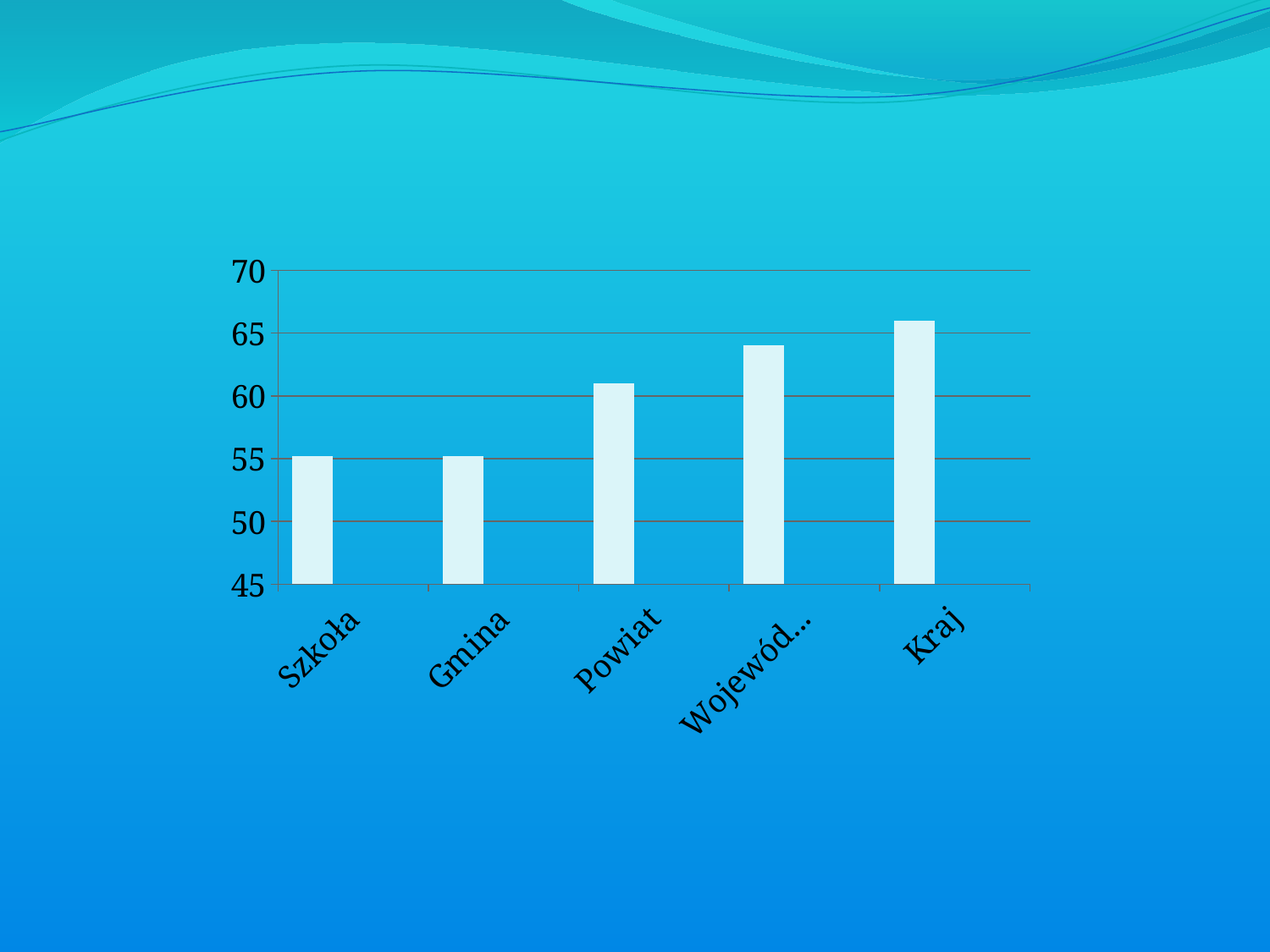
Which is larger, the value for Kraj or the value for Powiat? Kraj Do the bar values generally rise or fall from Szkoła on the left to Kraj on the right? rise Is the value for Powiat greater or less than 60? greater What is the lowest value shown on the vertical axis of the chart? 45 Which is larger, the value for Powiat or the value for Gmina? Powiat What is the highest value shown on the vertical axis of the chart? 70 Which category has the highest bar in the chart? Kraj What kind of chart is shown on the slide? bar chart Is the value for Szkoła greater or less than 60? less Is the value for Kraj greater or less than 65? greater How many categories are shown on the x axis of the chart? 5